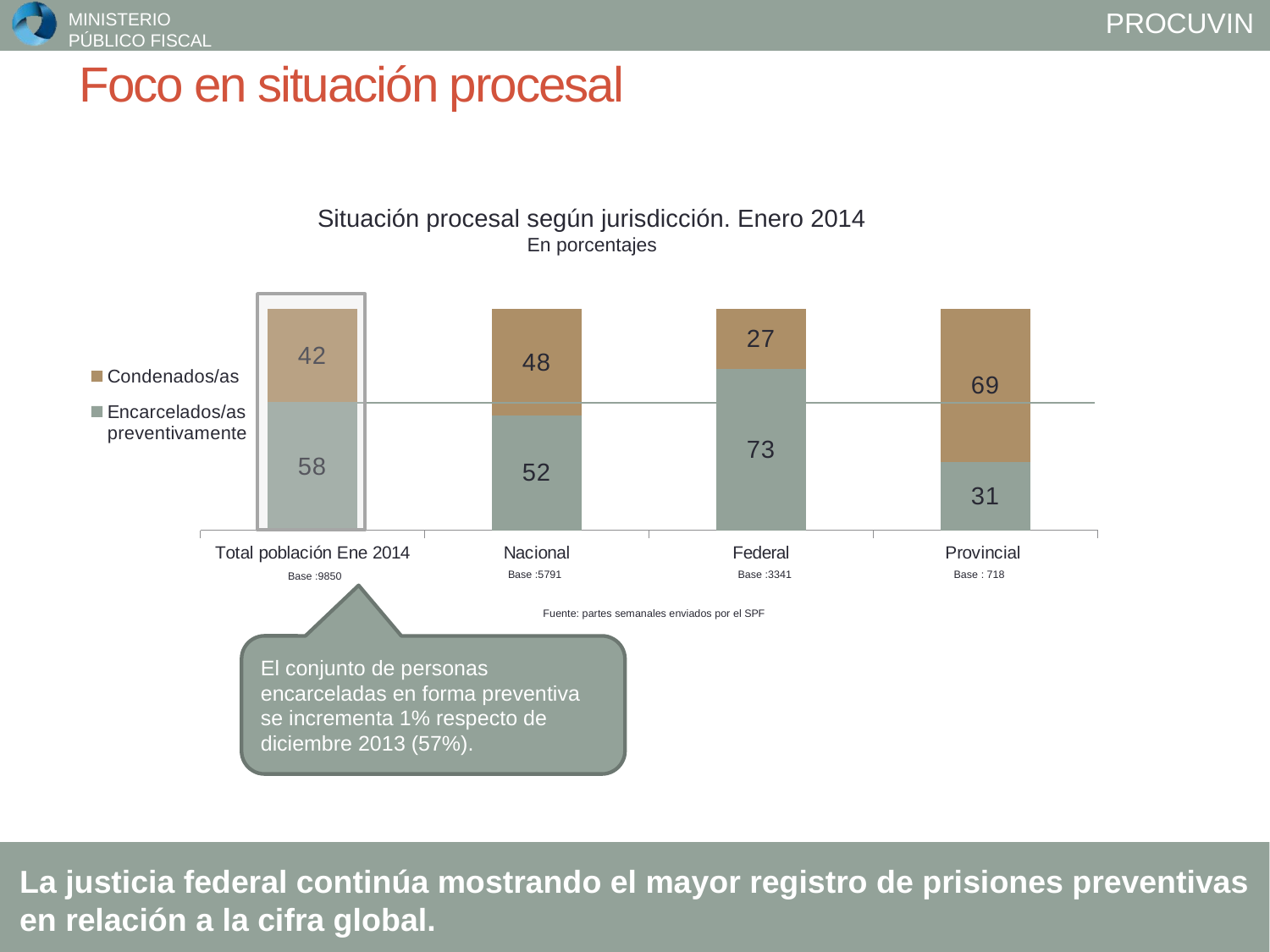
What is the value for Condenados/as in the Provincial category? 69 Which is larger: Condenados/as for Nacional or Condenados/as for Total población Ene 2014? Nacional How many series does the legend list? 2 What kind of chart is shown on the slide? Stacked bar chart Which category has the highest value for Encarcelados/as preventivamente? Federal What is the total of the stacked bar for Provincial? 100 What is the difference between the Encarcelados/as preventivamente values for Federal and Provincial? 42 Which category has the lowest value for Condenados/as? Federal What is the value for Condenados/as in the Nacional category? 48 What is the value for Encarcelados/as preventivamente in the Total población Ene 2014 category? 58 What is the value for Encarcelados/as preventivamente in the Federal category? 73 How many categories are shown on the x axis? 4